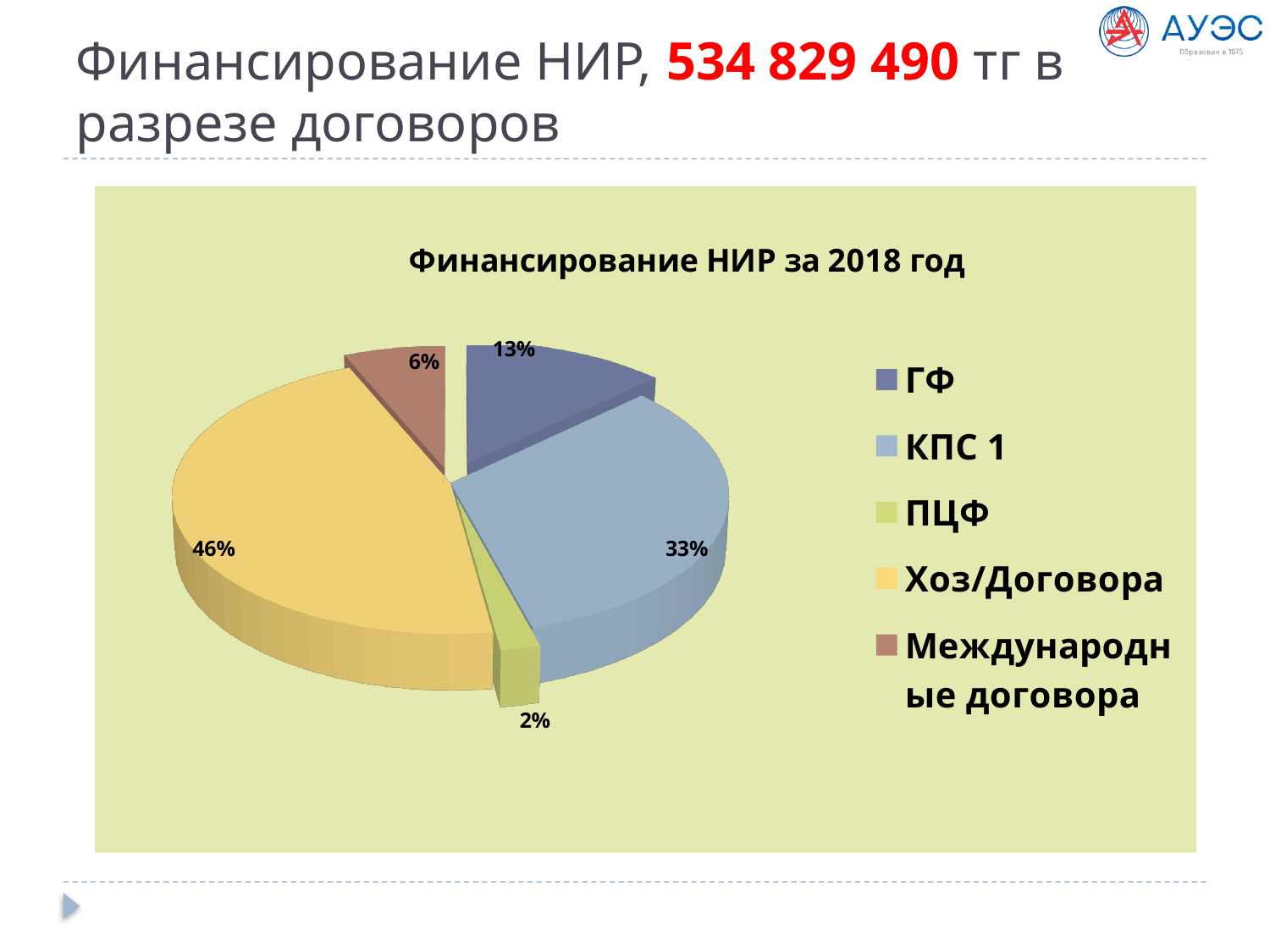
What share of the pie does ГФ take? 13% What share of the pie does Международные договора take? 6% Which slice is larger, ГФ or Международные договора? ГФ How many categories does the pie chart show? 5 What kind of chart is shown on the slide? Pie chart What is the difference in percentage points between the Хоз/Договора slice and the КПС 1 slice? 13% What share of the pie does Хоз/Договора take? 46% Which category has the smallest slice of the pie? ПЦФ What is the title of the chart? Финансирование НИР за 2018 год Which category has the largest slice of the pie? Хоз/Договора